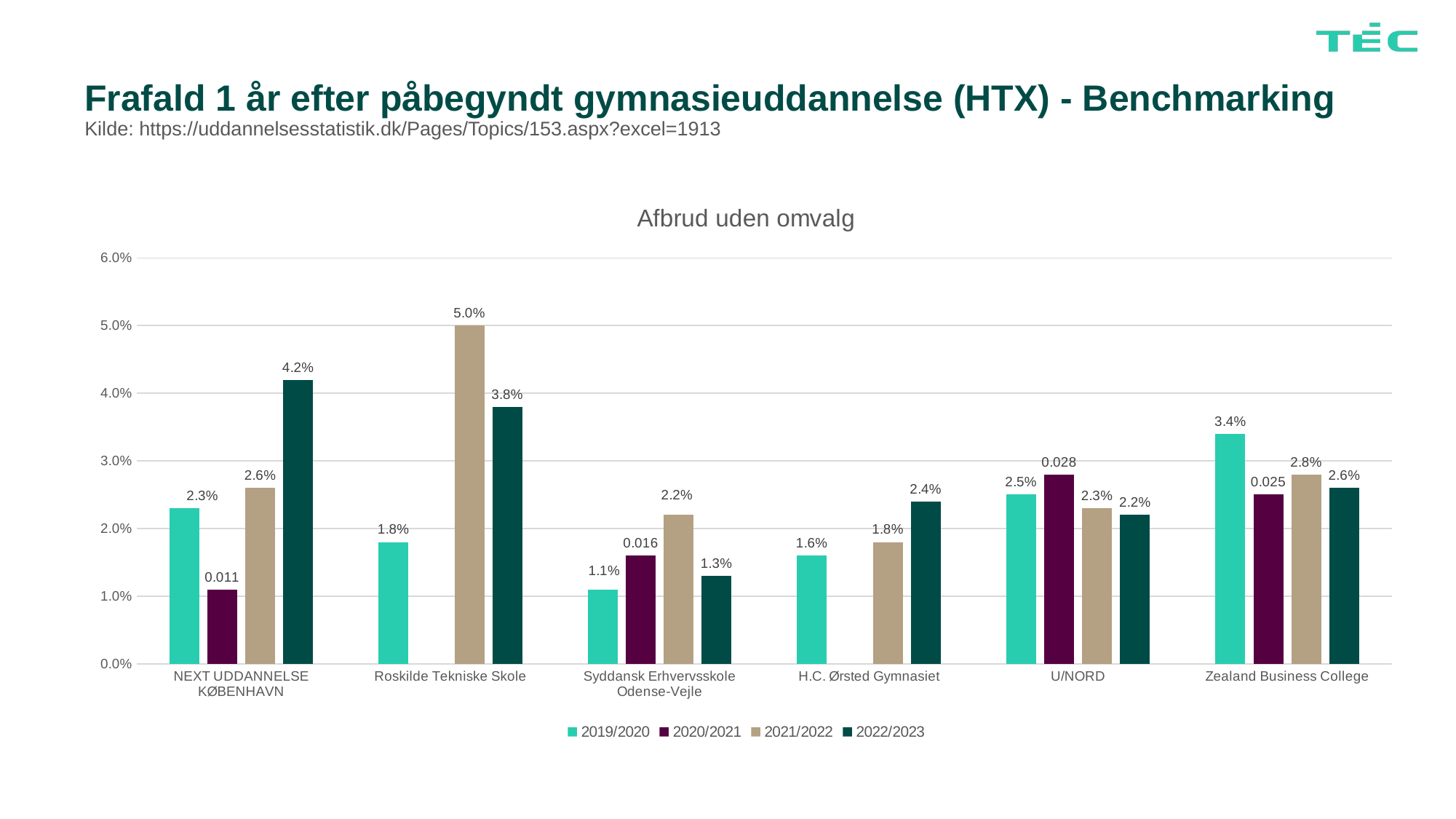
What is the difference between the 2021/2022 and 2022/2023 values for Roskilde Tekniske Skole? 1.2% What is the title of the chart? Afbrud uden omvalg How many schools (categories) are shown on the x axis? 6 What is the 2019/2020 value for Zealand Business College? 3.4% How many series does the legend list? 4 Which school has the lowest 2019/2020 value? Syddansk Erhvervsskole Odense-Vejle What is the 2021/2022 value for Roskilde Tekniske Skole? 5.0% Which school has the highest 2021/2022 value? Roskilde Tekniske Skole Which is larger for U/NORD: the 2019/2020 value or the 2022/2023 value? 2019/2020 What is the 2022/2023 value for NEXT UDDANNELSE KØBENHAVN? 4.2% What type of chart is shown on the slide? bar chart Do the values for H.C. Ørsted Gymnasiet rise or fall from 2019/2020 to 2022/2023? rise